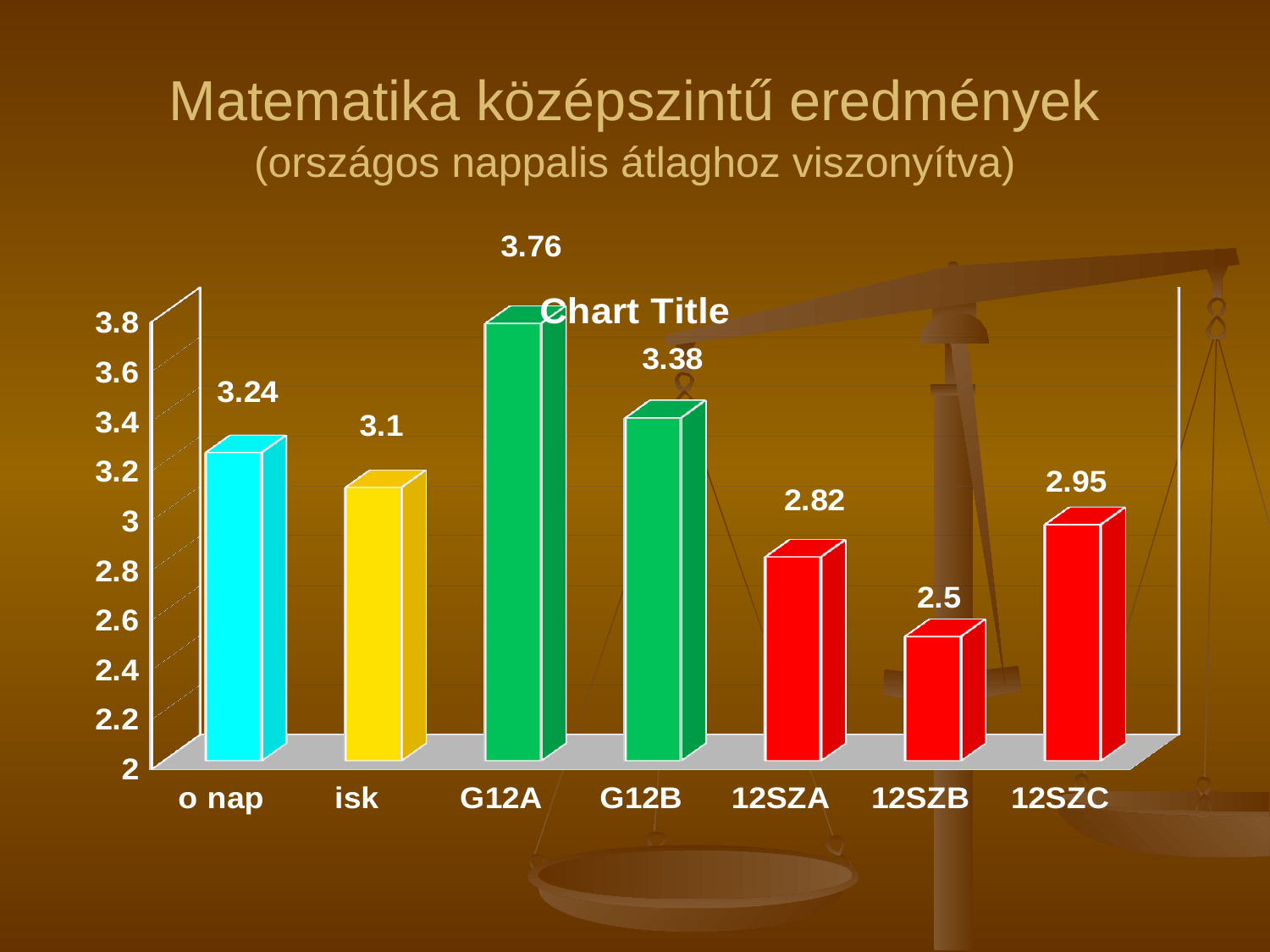
What kind of chart is shown on the slide? bar chart What is the difference between the values for G12A and G12B? 0.38 What is the value for G12A? 3.76 What is the value for o nap? 3.24 How many categories are shown on the x axis? 7 Is the value for 12SZA greater or less than 3? less Which category has the highest value? G12A Which is larger, the value for 12SZA or the value for 12SZC? 12SZC What is the value for 12SZB? 2.5 Which category has the lowest value? 12SZB What is the difference between the values for o nap and isk? 0.14 What is the value for 12SZC? 2.95